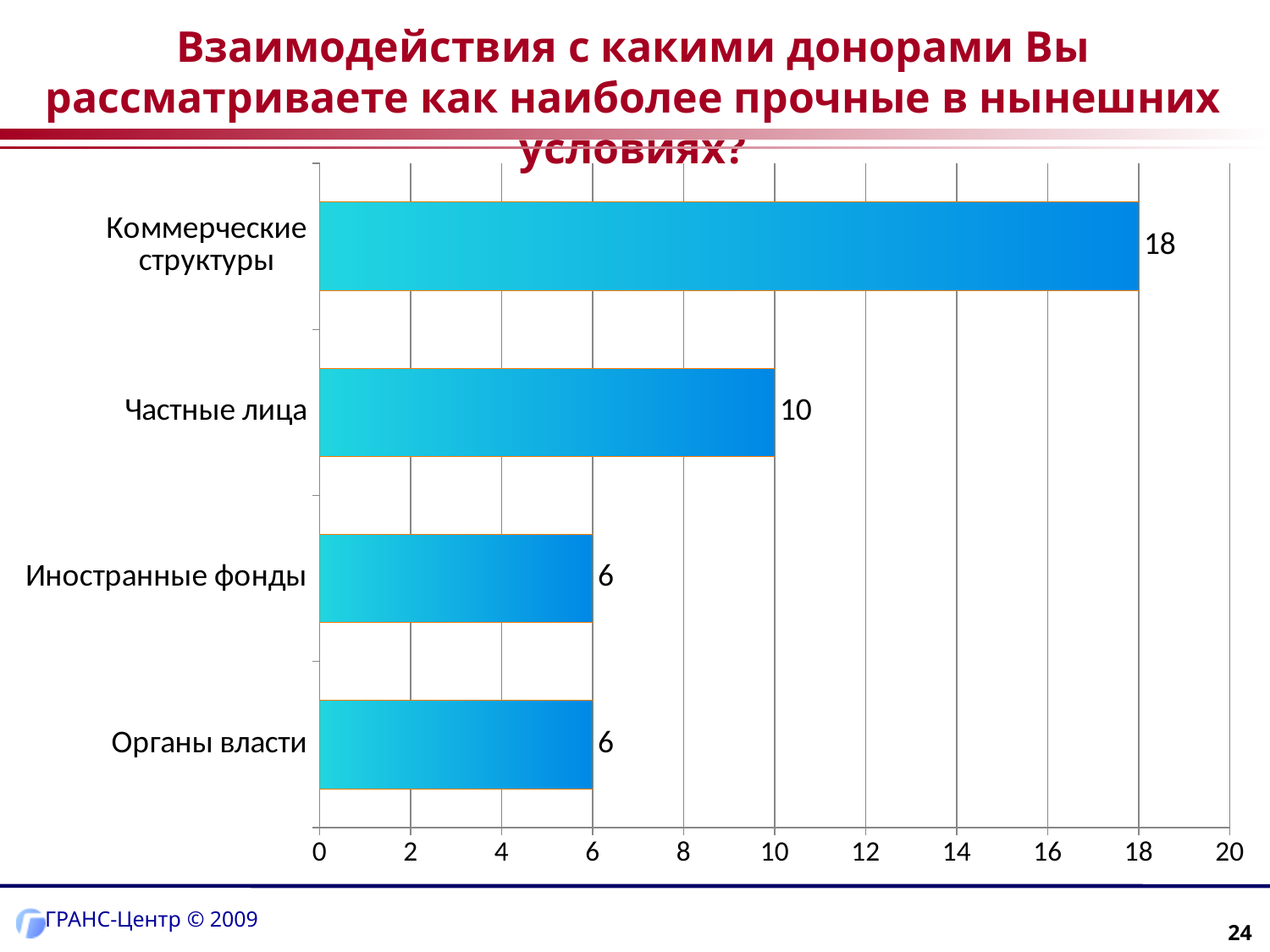
What is the value for Органы власти? 6 How many categories are shown in the chart? 4 What is the difference between the values for Коммерческие структуры and Частные лица? 8 What is the value for Коммерческие структуры? 18 Which is larger, the value for Частные лица or the value for Органы власти? Частные лица What is the difference between the values for Частные лица and Иностранные фонды? 4 What is the value for Частные лица? 10 What is the value for Иностранные фонды? 6 Which category has the highest value? Коммерческие структуры Is the value for Коммерческие структуры greater or less than 16? greater What is the maximum value shown on the horizontal axis? 20 What kind of chart is shown on the slide? bar chart